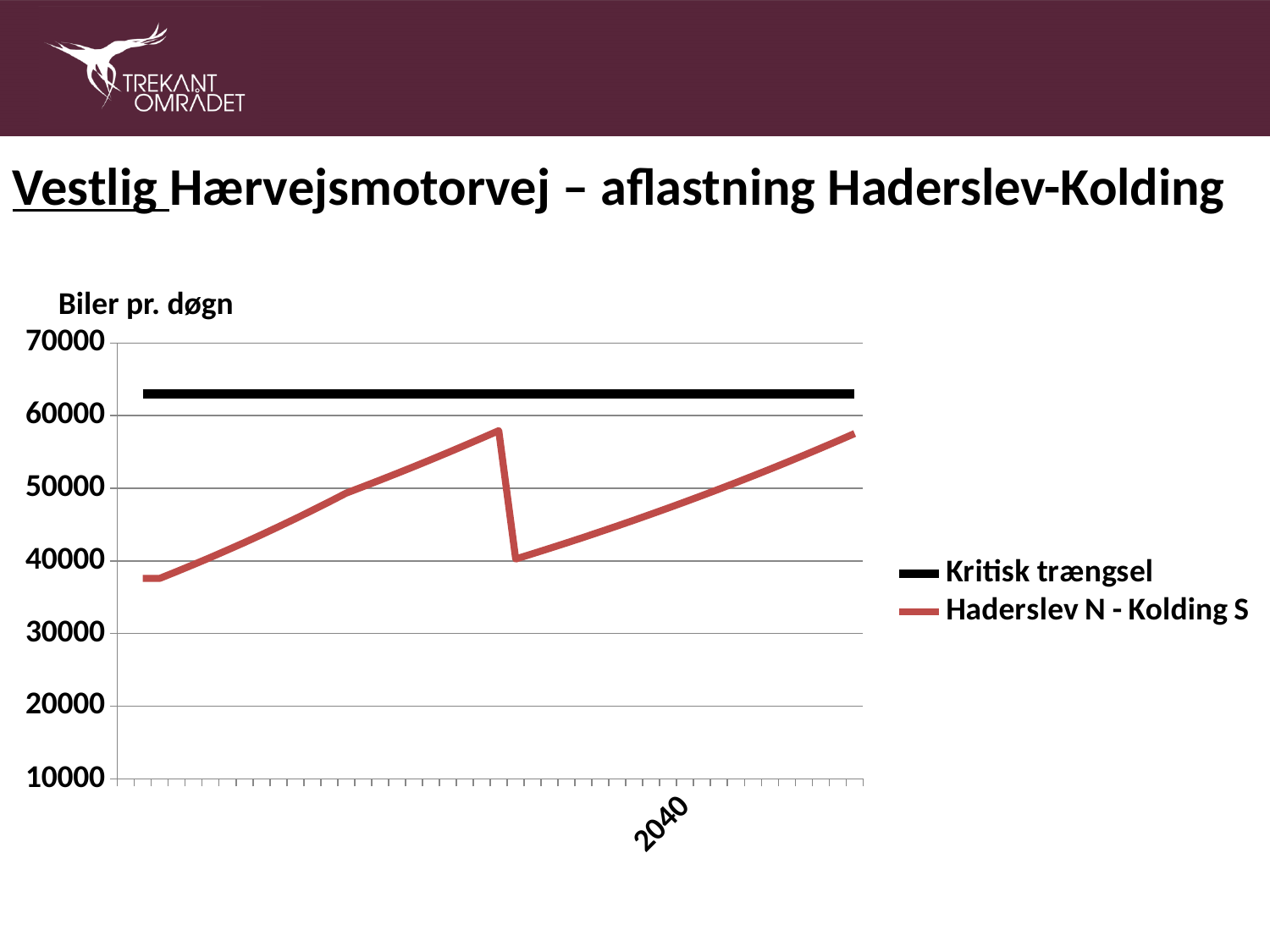
Which year is labelled on the x axis of the chart? 2040 Which series has the higher value at 2040, Kritisk trængsel or Haderslev N - Kolding S? Kritisk trængsel Is the highest point of the Haderslev N - Kolding S line greater or less than 60000? less What kind of chart is shown on the slide? line chart What is the highest tick value shown on the y axis? 70000 What is the label shown above the y axis of the chart? Biler pr. døgn What are the two series named in the legend? Kritisk trængsel; Haderslev N - Kolding S How many series does the legend list? 2 Is the value of the Haderslev N - Kolding S line at its starting point (left end) greater or less than 40000? less Does the Haderslev N - Kolding S line rise or fall along the x axis after 2040? rise Is the value of the Kritisk trængsel line greater or less than 60000? greater